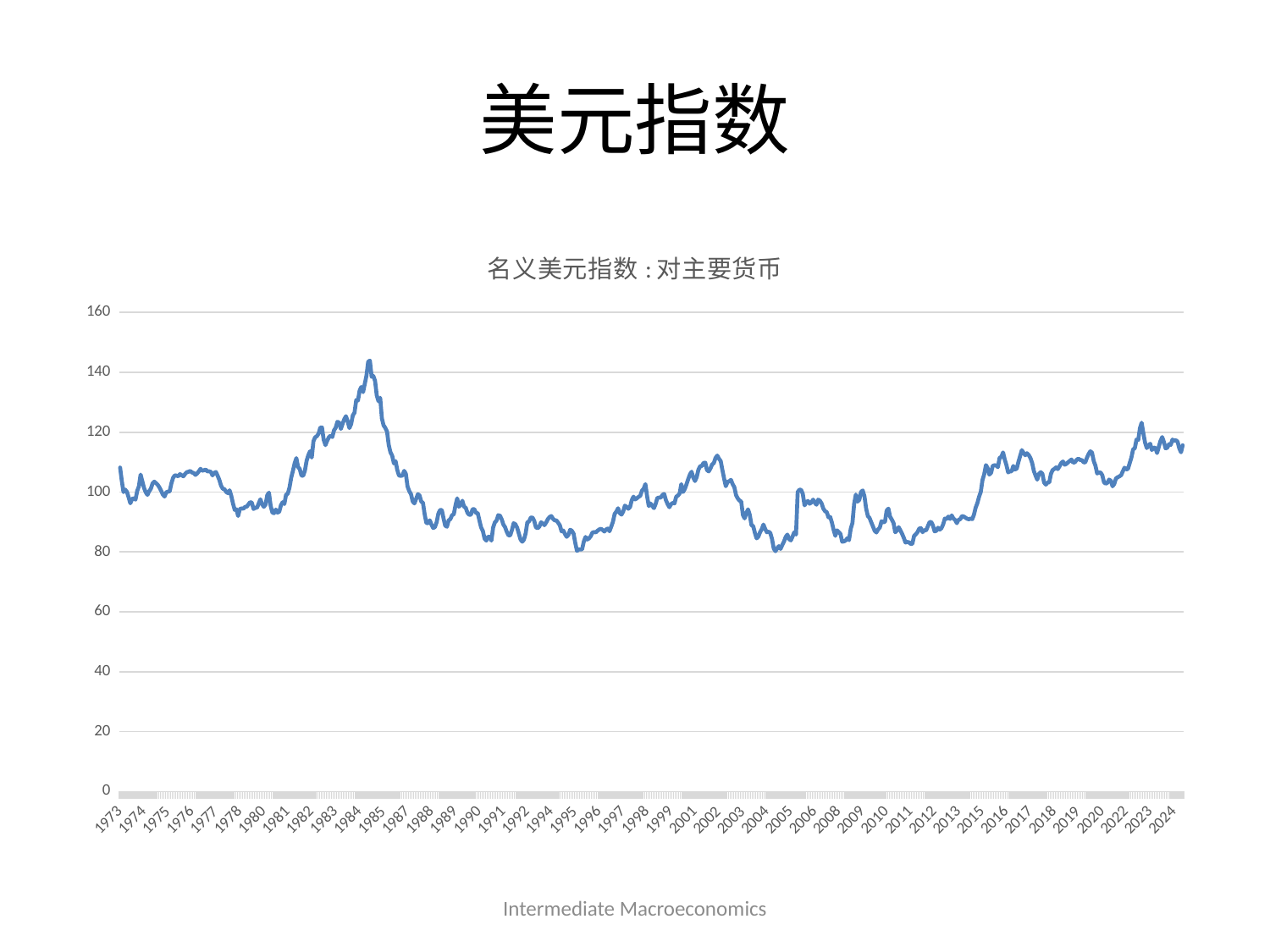
Which is larger, the index value around 1995 or around 2001? 2001 Does the index rise or fall between 1985 and 1995? fall Does the index rise or fall between 2011 and 2022? rise Which is larger, the index value around 1985 or around 2022? 1985 Is the value of the index around 1985 greater or less than 120? greater Is the value of the index around 2022 greater or less than 100? greater Is the value of the index around 1995 greater or less than 100? less Around which year does the index reach its highest value? 1985 What is the highest value shown on the vertical axis? 160 What kind of chart is shown on the slide? line chart What is the title of the chart? 名义美元指数：对主要货币